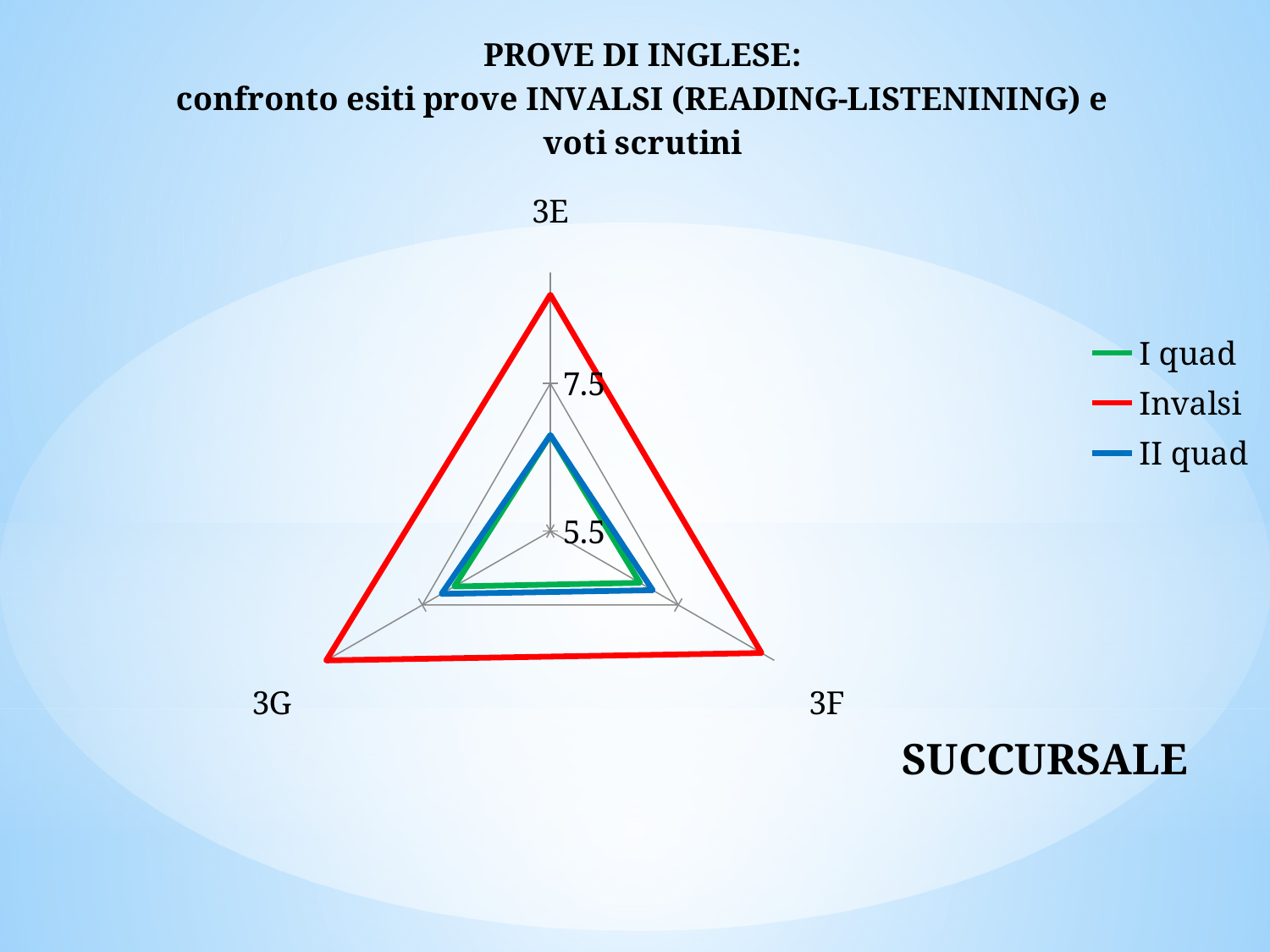
Is the Invalsi value for 3E greater or less than 7.5? greater How many series does the legend list? 3 Is the I quad value for 3G greater or less than 5.5? greater Is the Invalsi value for 3G greater or less than 7.5? greater For class 3F, which series has the highest value? Invalsi For class 3E, which is larger: the Invalsi value or the I quad value? Invalsi How many classes (categories) are plotted on the radar chart? 3 Which series is plotted with a red line? Invalsi What kind of chart is shown on the slide? Radar chart What are the three series listed in the legend? I quad, Invalsi, II quad